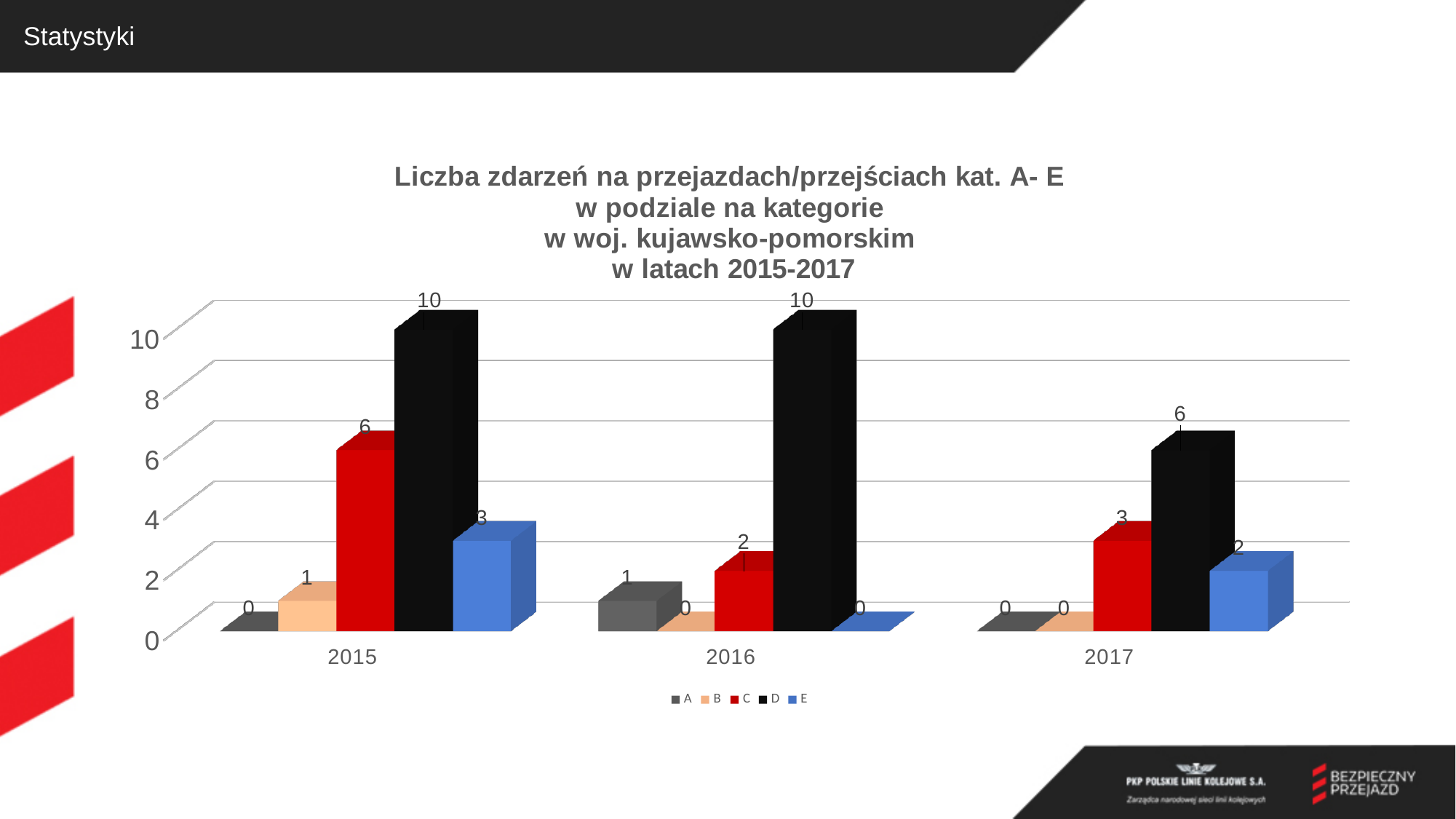
Which category has the highest value in 2017? D What is the difference between the values for category C and category E in 2015? 3 Which category has the highest value in 2015? D What is the value for category E in 2017? 2 What is the value for category B in 2015? 1 How many years are shown on the x axis? 3 How many series does the legend list? 5 What is the difference between the values for category D in 2015 and 2017? 4 What is the value for category C in 2016? 2 What kind of chart is shown on the slide? bar chart What is the value for category D in 2015? 10 Which is larger: the value for category C in 2015 or the value for category C in 2017? 2015